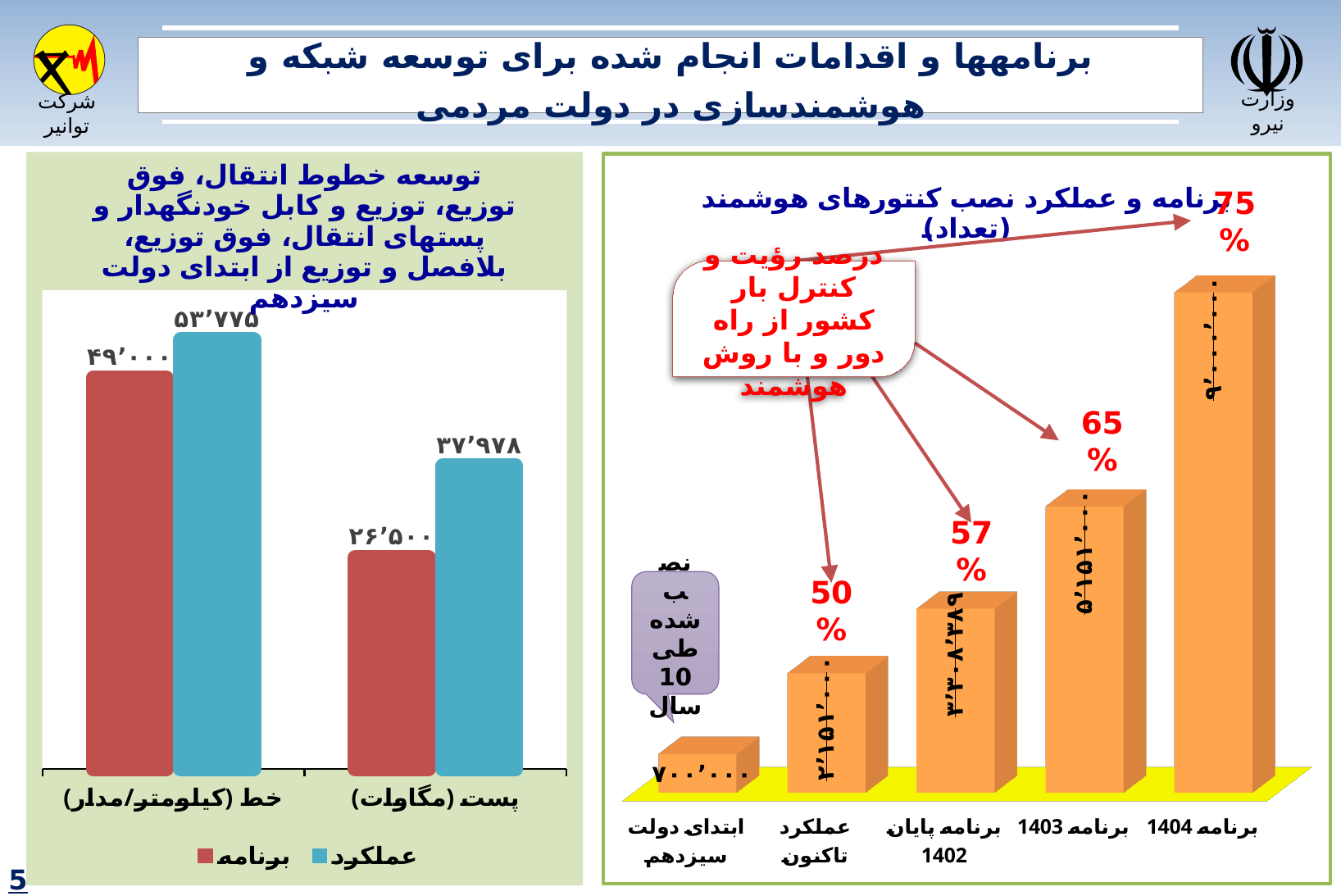
In the left chart, what is the value of عملکرد for خط (کیلومتر/مدار)? ۵۳’۷۷۵ In the left chart, what is the difference between عملکرد and برنامه for پست (مگاوات)? ۱۱’۴۷۸ In the left chart, what is the value of برنامه for خط (کیلومتر/مدار)? ۴۹’۰۰۰ In the left chart, what is the difference between عملکرد and برنامه for خط (کیلومتر/مدار)? ۴’۷۷۵ What type of chart is the left chart on the slide? bar chart In the left chart, what is the value of عملکرد for پست (مگاوات)? ۳۷’۹۷۸ In the right chart (برنامه و عملکرد نصب کنتورهای هوشمند), what is the value for ابتدای دولت سیزدهم? ۷۰۰’۰۰۰ How many series does the legend of the left chart list? 2 In the right chart (برنامه و عملکرد نصب کنتورهای هوشمند), which category has the highest bar? برنامه 1404 In the left chart, what is the value of برنامه for پست (مگاوات)? ۲۶’۵۰۰ How many categories are shown on the x axis of the right chart (برنامه و عملکرد نصب کنتورهای هوشمند)? 5 In the left chart, which is larger for پست (مگاوات): برنامه or عملکرد? عملکرد